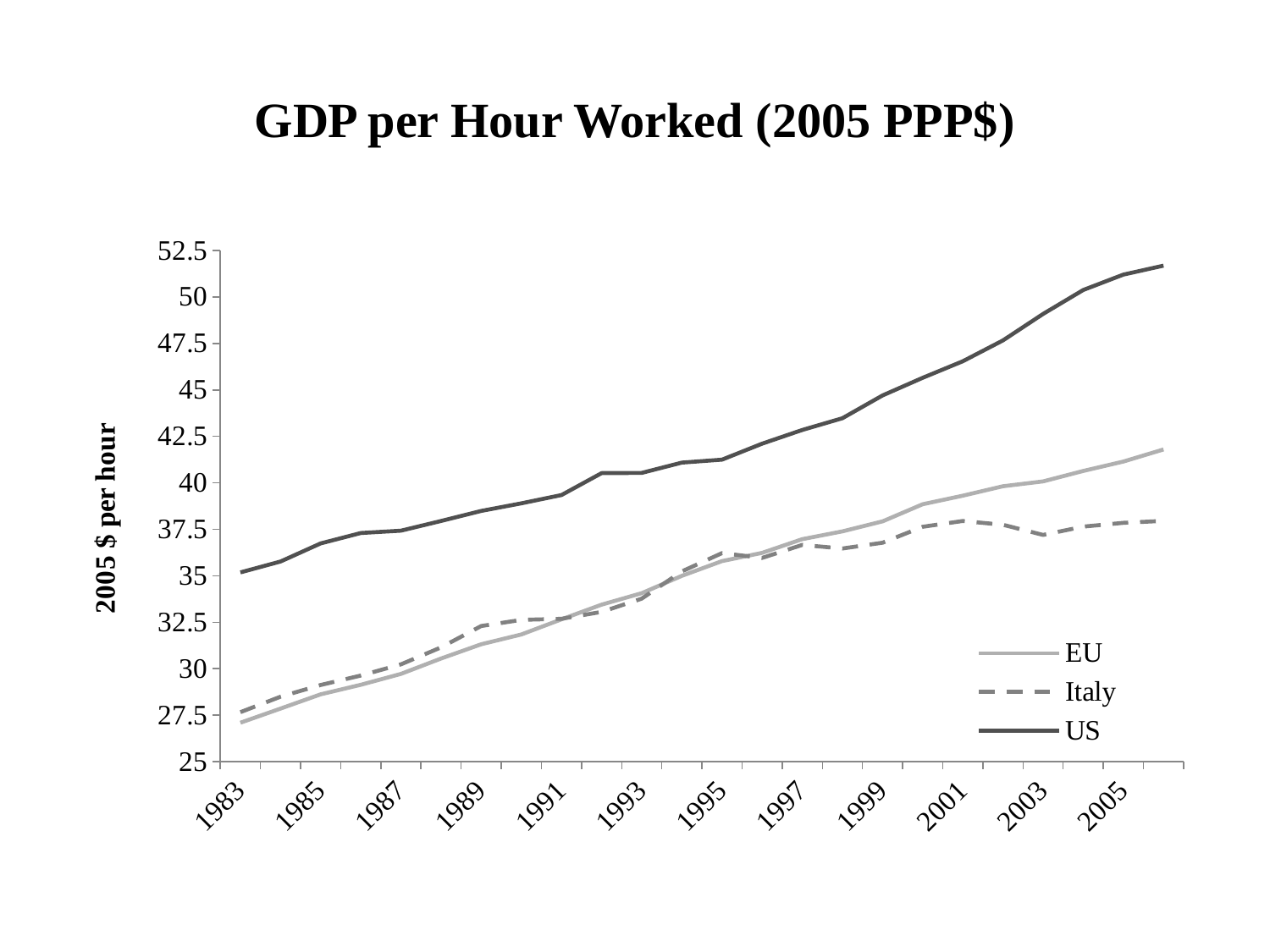
Which series has the lowest value in 2005? Italy What kind of chart is shown on the slide? line chart What is the label on the vertical axis? 2005 $ per hour What is the title of the chart? GDP per Hour Worked (2005 PPP$) Does the US series rise or fall from 1983 to 2005? rise Is the value for US in 1995 greater or less than 40? greater How many series does the legend list? 3 Is the value for EU in 1983 greater or less than 30? less Which series has the highest value in 2005? US Is the value for Italy in 2005 greater or less than 40? less In 2005, which is larger, the value for EU or the value for Italy? EU